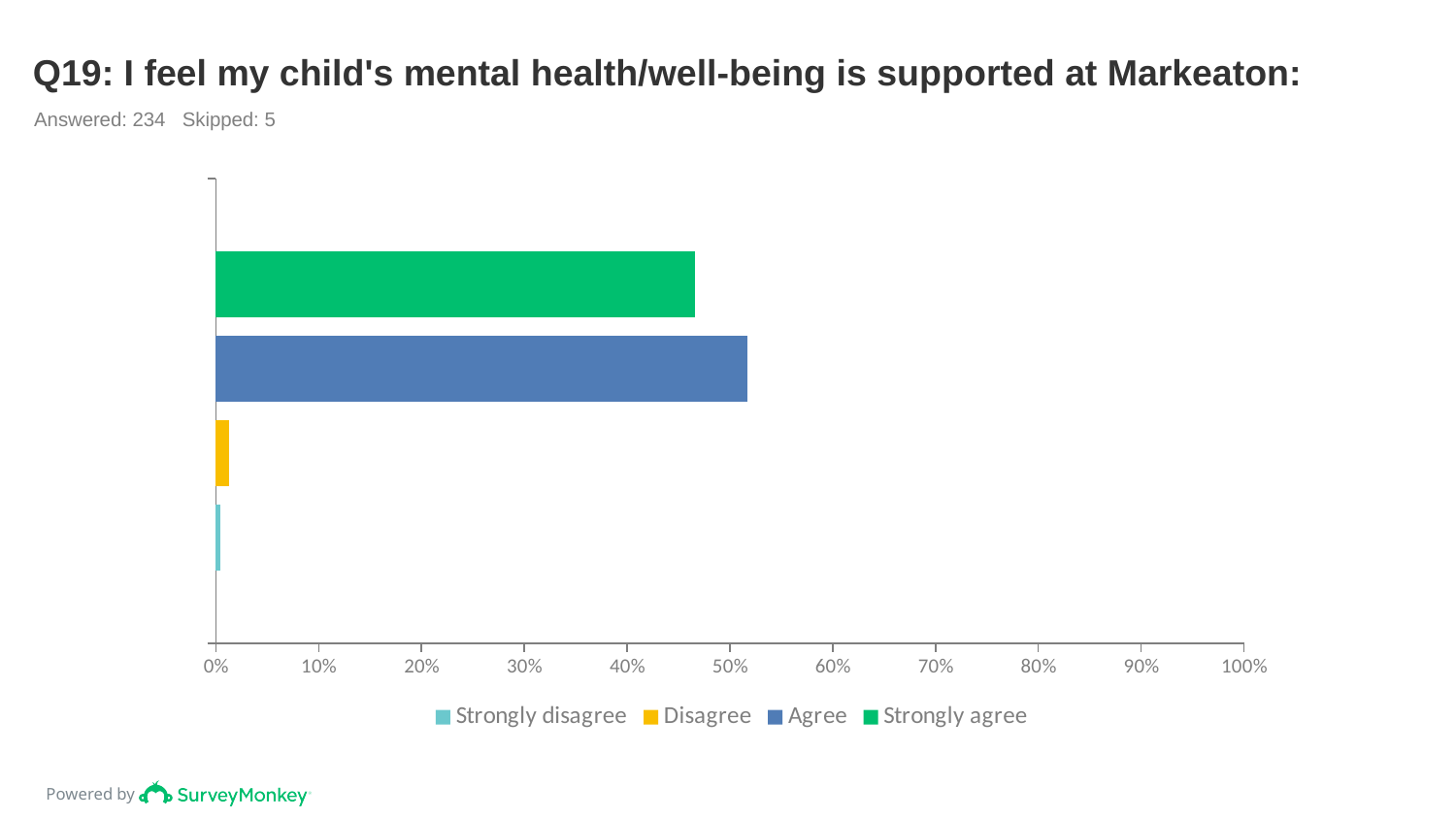
How many series does the legend list? 4 Is the value for Strongly agree greater or less than 50%? less Is the value for Strongly agree greater or less than 30%? greater Which is larger, the value for Disagree or the value for Strongly disagree? Disagree Which response has the longest bar? Agree What kind of chart is shown on the slide? bar chart Which response has the shortest bar? Strongly disagree Which is larger, the value for Agree or the value for Strongly agree? Agree What is the title of the chart? Q19: I feel my child's mental health/well-being is supported at Markeaton: How many respondents answered the question according to the slide? 234 Is the value for Agree greater or less than 40%? greater